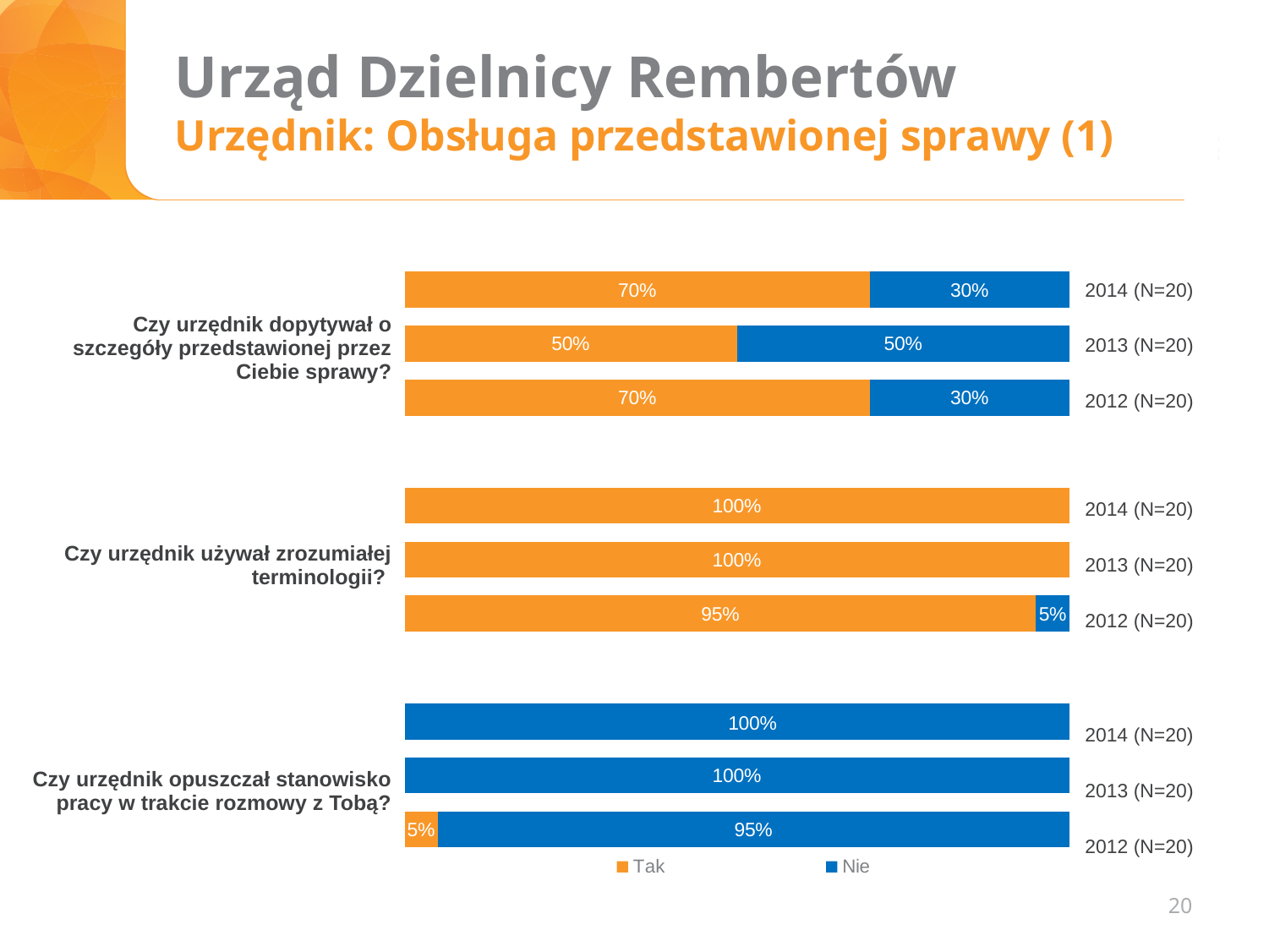
For the question 'Czy urzędnik używał zrozumiałej terminologii?', is the 'Tak' value for 2012 (N=20) larger or smaller than the 'Tak' value for 2013 (N=20)? smaller For the question 'Czy urzędnik opuszczał stanowisko pracy w trakcie rozmowy z Tobą?', what is the 'Tak' value for 2012 (N=20)? 5% For the question 'Czy urzędnik dopytywał o szczegóły przedstawionej przez Ciebie sprawy?', which year has the lowest 'Tak' value? 2013 (N=20) What are the two series named in the legend? Tak and Nie For the question 'Czy urzędnik używał zrozumiałej terminologii?', what is the 'Nie' value for 2012 (N=20)? 5% For the question 'Czy urzędnik opuszczał stanowisko pracy w trakcie rozmowy z Tobą?', what is the 'Nie' value for 2014 (N=20)? 100% For the question 'Czy urzędnik dopytywał o szczegóły przedstawionej przez Ciebie sprawy?', what is the difference between the 'Tak' and 'Nie' values in 2014 (N=20)? 40% What kind of chart is shown on the slide? stacked bar chart How many series does the legend list? 2 For the question 'Czy urzędnik dopytywał o szczegóły przedstawionej przez Ciebie sprawy?', what is the 'Tak' value for 2014 (N=20)? 70% How many bars are shown for the question 'Czy urzędnik używał zrozumiałej terminologii?'? 3 For the question 'Czy urzędnik dopytywał o szczegóły przedstawionej przez Ciebie sprawy?', what is the 'Nie' value for 2013 (N=20)? 50%